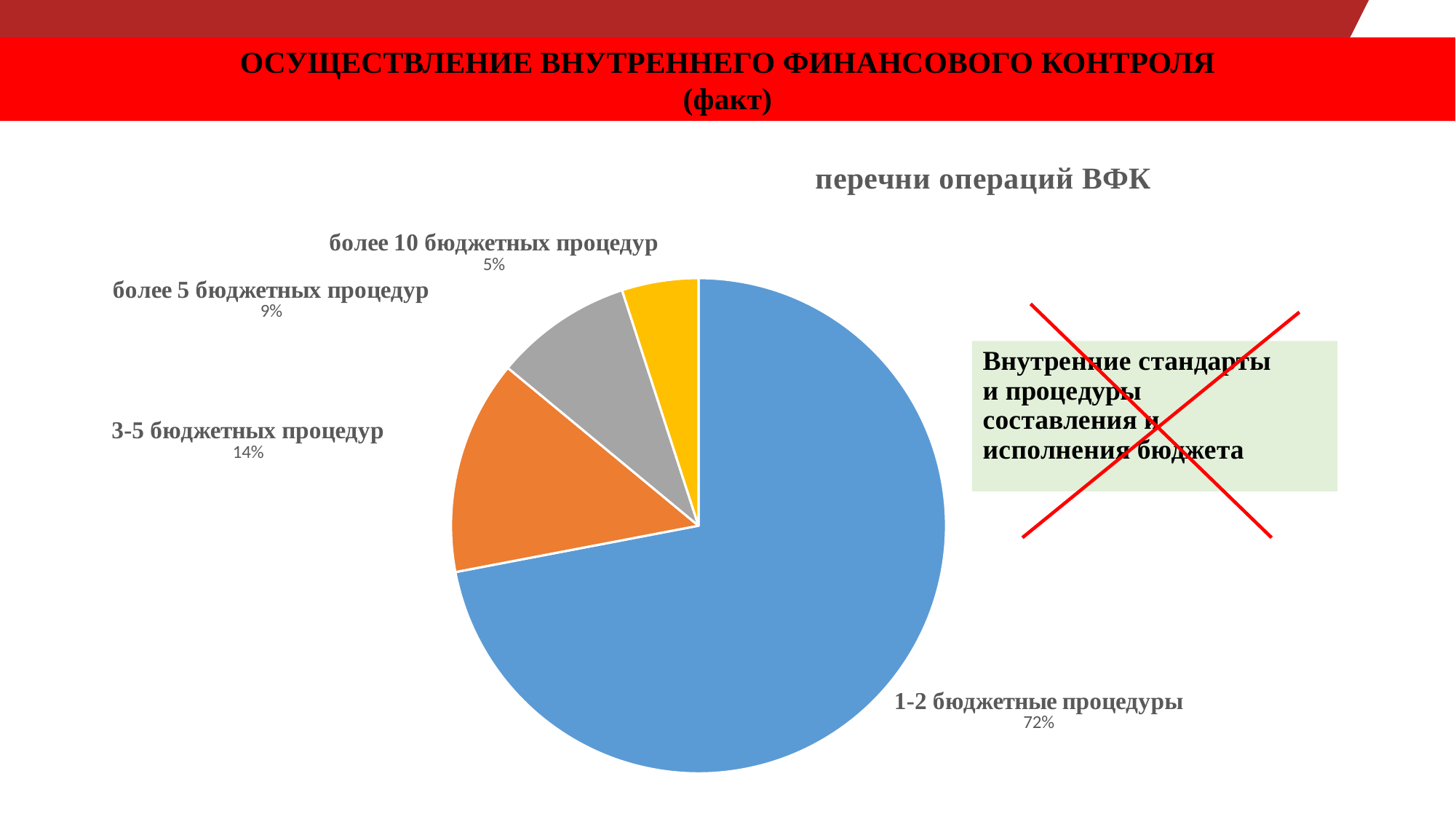
What kind of chart is shown on the slide? pie chart Which category has the smallest slice of the pie? более 10 бюджетных процедур What share of the pie does "3-5 бюджетных процедур" have? 14% What colour is the slice for "3-5 бюджетных процедур"? orange What share of the pie does "1-2 бюджетные процедуры" have? 72% What share of the pie does "более 5 бюджетных процедур" have? 9% Which is larger: the share for "более 5 бюджетных процедур" or for "более 10 бюджетных процедур"? более 5 бюджетных процедур How many slices does the pie chart have? 4 What is the difference in percentage points between "1-2 бюджетные процедуры" and "3-5 бюджетных процедур"? 58 What is the title of the chart? перечни операций ВФК Which category has the largest slice of the pie? 1-2 бюджетные процедуры